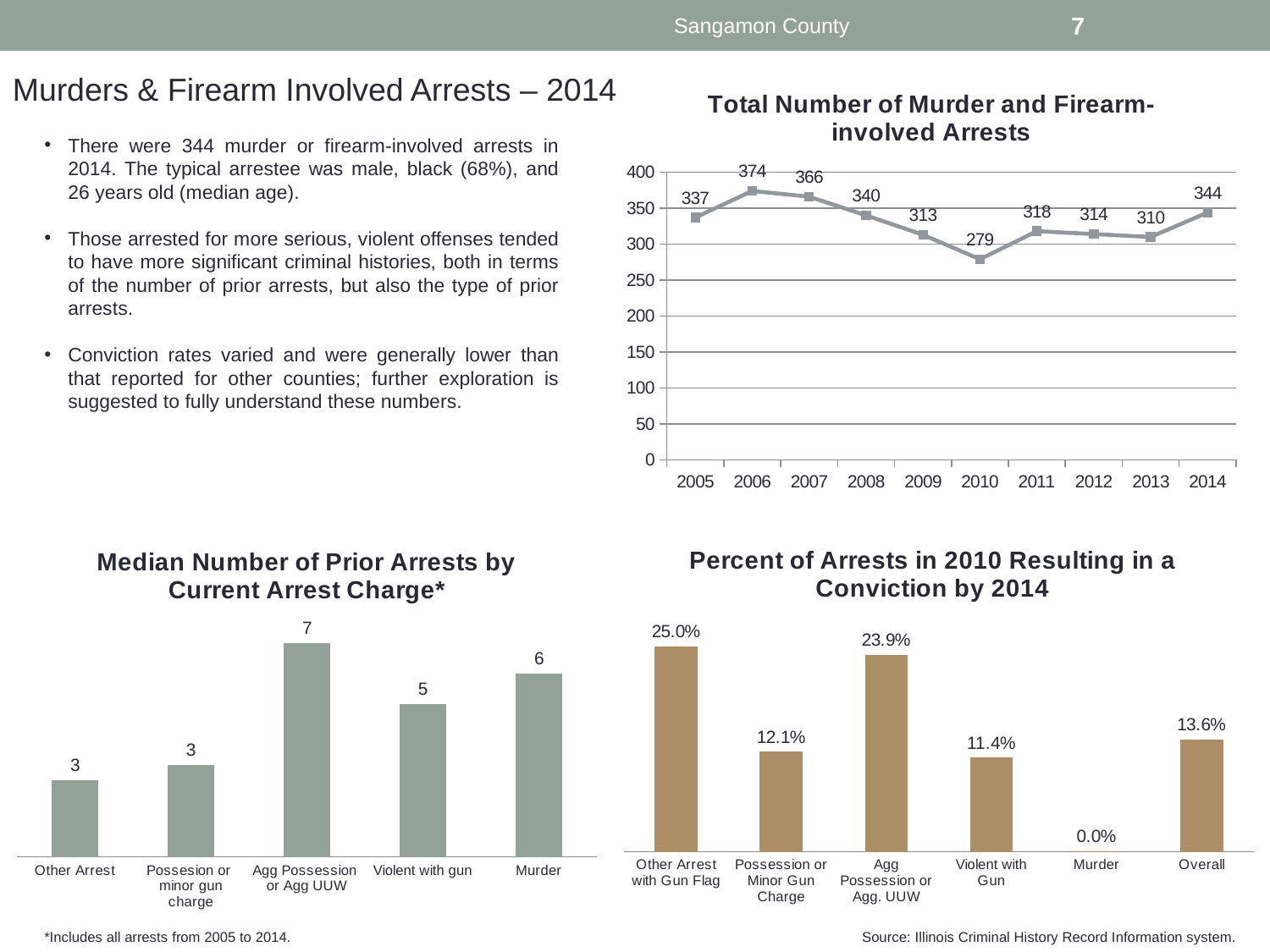
In the 'Total Number of Murder and Firearm-involved Arrests' chart, what was the value for 2010? 279 In the 'Total Number of Murder and Firearm-involved Arrests' chart, how many years are plotted? 10 In the 'Total Number of Murder and Firearm-involved Arrests' chart, which year had the highest number of arrests? 2006 In the 'Median Number of Prior Arrests by Current Arrest Charge*' chart, which category has the highest median number of prior arrests? Agg Possession or Agg UUW In the 'Percent of Arrests in 2010 Resulting in a Conviction by 2014' chart, what is the difference between Other Arrest with Gun Flag and Violent with Gun? 13.6% In the 'Percent of Arrests in 2010 Resulting in a Conviction by 2014' chart, what is the value for Overall? 13.6% What kind of chart is 'Total Number of Murder and Firearm-involved Arrests'? Line chart In the 'Total Number of Murder and Firearm-involved Arrests' chart, which year had the lowest number of arrests? 2010 In the 'Total Number of Murder and Firearm-involved Arrests' chart, what is the difference between the 2006 and 2014 values? 30 In the 'Percent of Arrests in 2010 Resulting in a Conviction by 2014' chart, which category has the lowest value? Murder In the 'Median Number of Prior Arrests by Current Arrest Charge*' chart, which is larger: Violent with gun or Murder? Murder In the 'Median Number of Prior Arrests by Current Arrest Charge*' chart, what is the value for Agg Possession or Agg UUW? 7